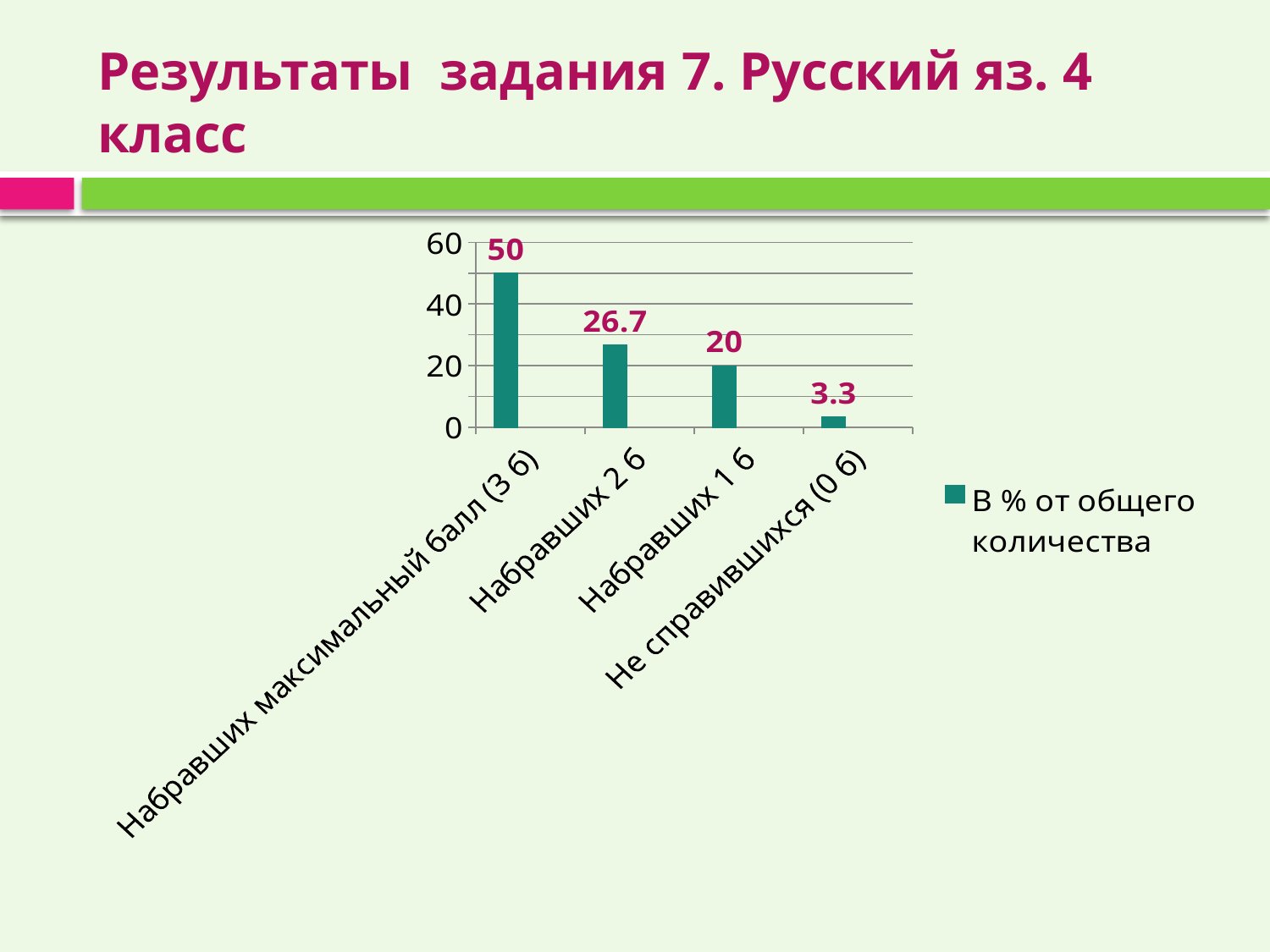
What is the value for "Набравших 1 б"? 20 What is the difference between the values for "Набравших максимальный балл (3 б)" and "Набравших 2 б"? 23.3 What is the value for "Набравших максимальный балл (3 б)"? 50 Which category has the highest value? Набравших максимальный балл (3 б) What is the legend entry for the series shown? В % от общего количества What kind of chart is shown on the slide? bar chart Which category has the lowest value? Не справившихся (0 б) What is the value for "Не справившихся (0 б)"? 3.3 How many categories are shown on the x axis? 4 What is the value for "Набравших 2 б"? 26.7 Is the value for "Набравших 2 б" greater or less than 40? less Which is larger: the value for "Набравших 1 б" or the value for "Не справившихся (0 б)"? Набравших 1 б